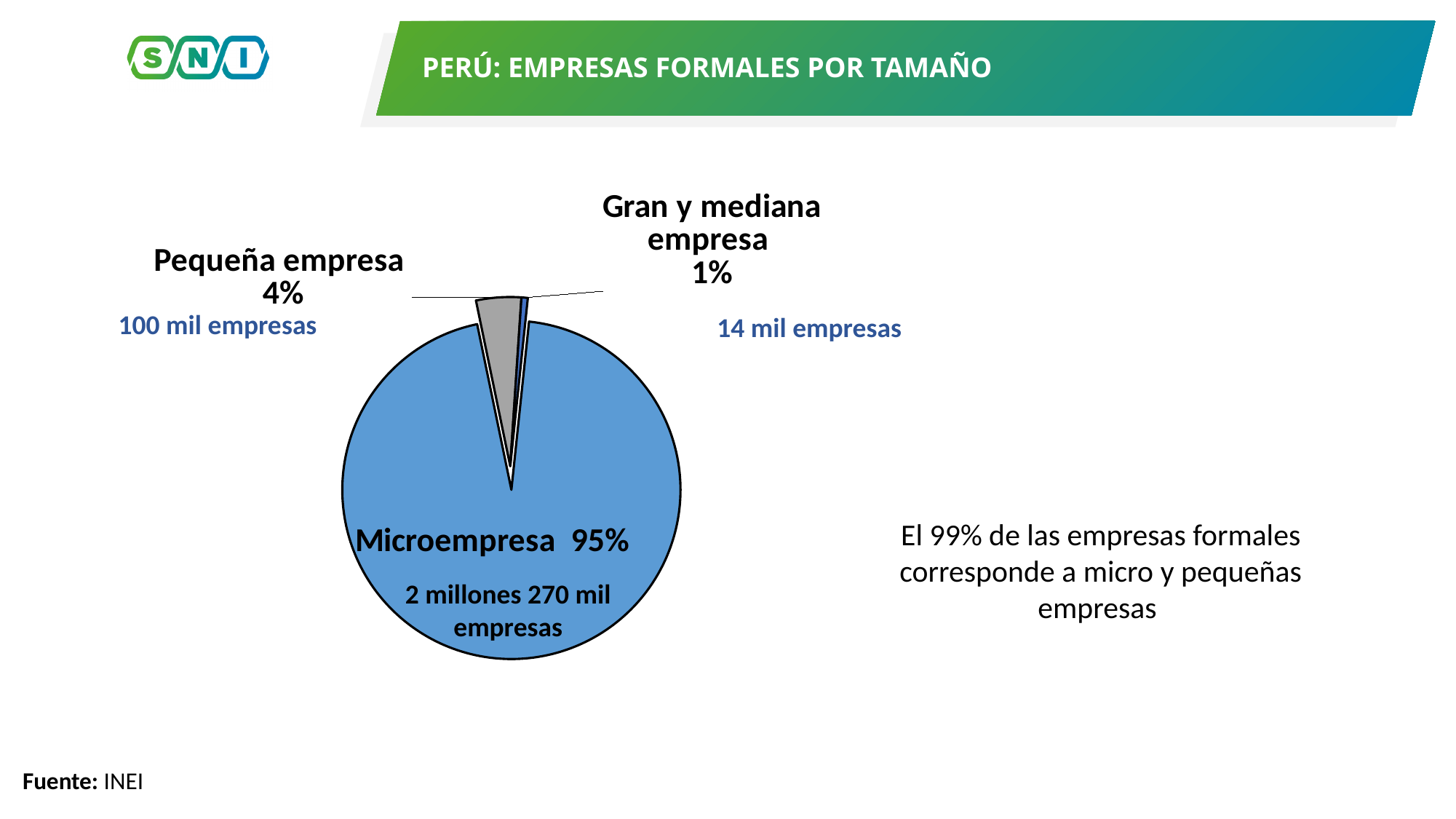
What share of the pie does Gran y mediana empresa represent? 1% What kind of chart is shown on the slide? pie chart What is the difference in percentage points between the Pequeña empresa share and the Gran y mediana empresa share? 3 percentage points What share of the pie does Pequeña empresa represent? 4% Which category has the smallest share of the pie? Gran y mediana empresa Which category has the largest share of the pie? Microempresa How many empresas are in the Pequeña empresa category? 100 mil empresas What is the title of the slide containing the chart? PERÚ: EMPRESAS FORMALES POR TAMAÑO How many categories does the pie chart have? 3 What share of the pie does Microempresa represent? 95% How many empresas are in the Gran y mediana empresa category? 14 mil empresas How many empresas are in the Microempresa category? 2 millones 270 mil empresas